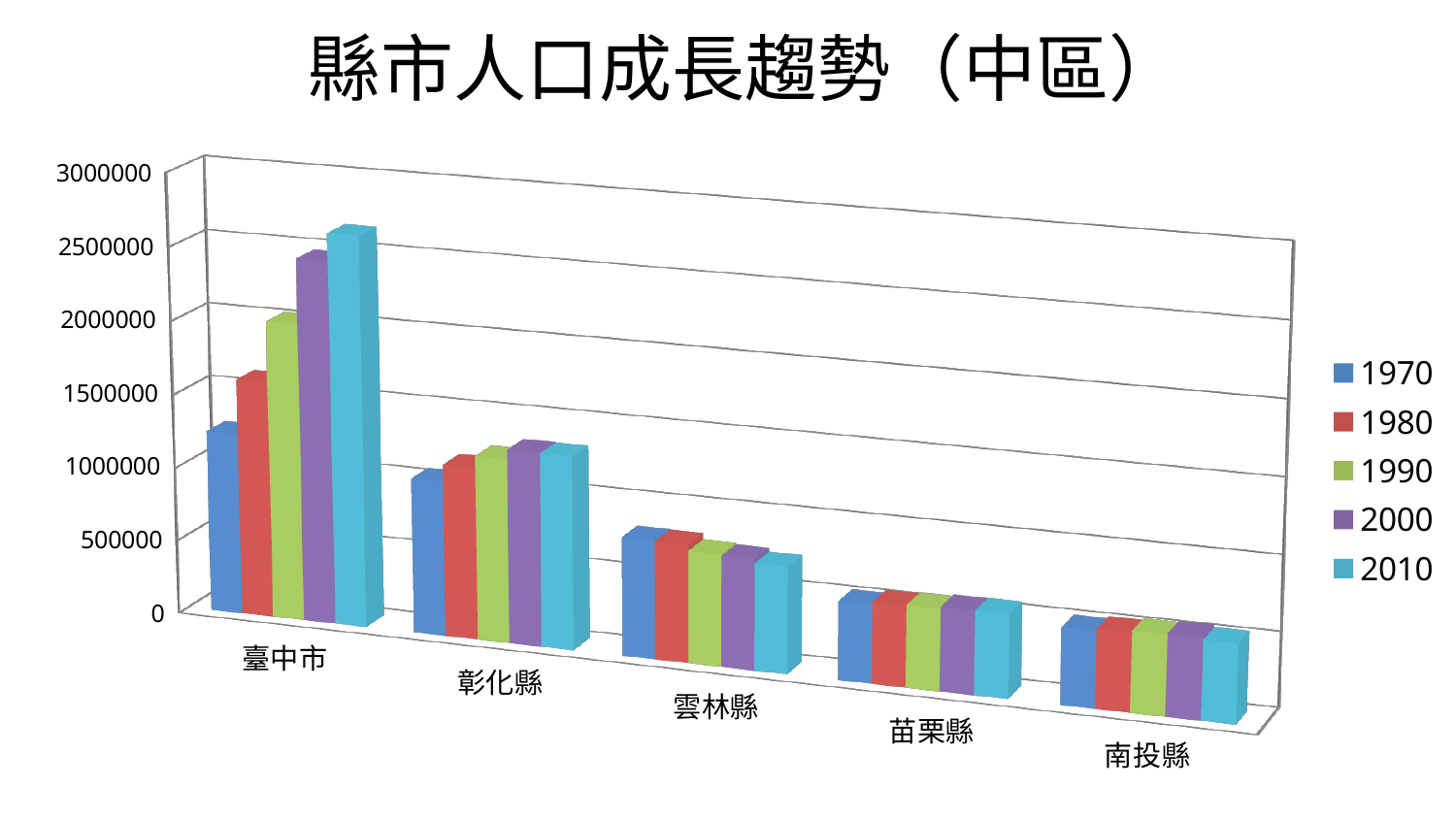
How many counties/cities are shown on the x axis? 5 Do the values for 雲林縣 rise or fall from 1970 to 2010? fall How many series does the legend list? 5 What is the title of the chart? 縣市人口成長趨勢（中區） For 臺中市, which year has the tallest bar? 2010 Which is larger in 2010, the value for 臺中市 or the value for 彰化縣? 臺中市 Which county/city has the highest population bars in the chart? 臺中市 What kind of chart is shown on the slide? bar chart Is the 1970 value for 臺中市 greater or less than 1000000? greater Is the 2000 value for 臺中市 greater or less than 2000000? greater Do the values for 臺中市 rise or fall from 1970 to 2010? rise Which county/city has the lowest population bars in the chart? 南投縣